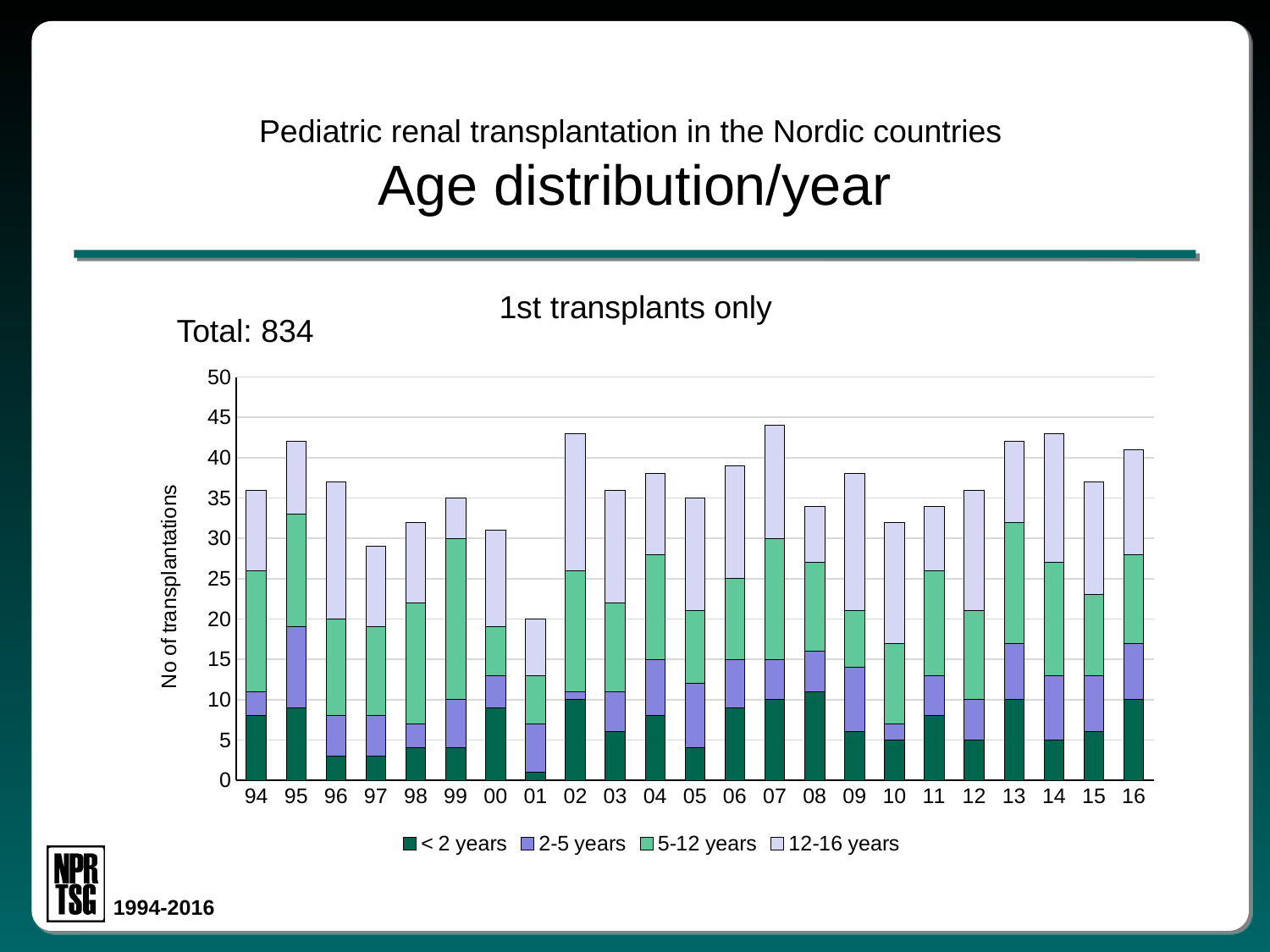
How many years (bars) are shown along the x axis of the chart? 23 Is the total number of transplantations for 07 greater or less than 40? greater What kind of chart is shown on the slide? Stacked bar chart Which year has the larger total number of transplantations, 01 or 02? 02 What total number of transplantations is printed above the chart? 834 Is the total number of transplantations for 99 greater or less than 40? less Is the total number of transplantations for 08 greater or less than 40? less Which year has the larger total number of transplantations, 95 or 97? 95 How many age groups does the chart's legend list? 4 Which year has the lowest total number of transplantations in the chart? 01